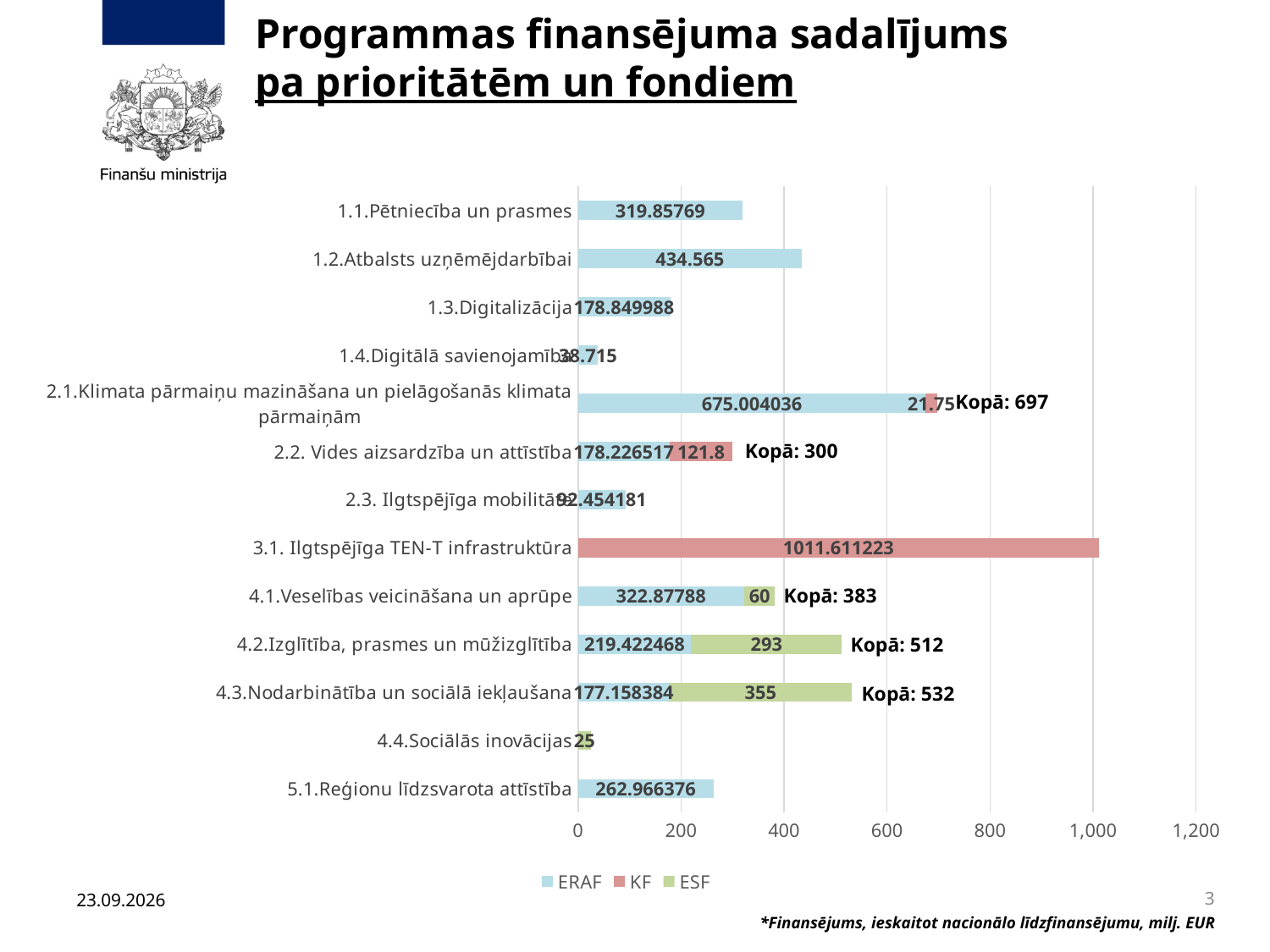
What is the ERAF value for 2.1.Klimata pārmaiņu mazināšana un pielāgošanās klimata pārmaiņām? 675.004036 What is the KF value for 3.1. Ilgtspējīga TEN-T infrastruktūra? 1011.611223 Which has the larger ESF value: 4.2.Izglītība, prasmes un mūžizglītība or 4.3.Nodarbinātība un sociālā iekļaušana? 4.3.Nodarbinātība un sociālā iekļaušana What is the difference between the ESF values for 4.3.Nodarbinātība un sociālā iekļaušana and 4.2.Izglītība, prasmes un mūžizglītība? 62 What is the ESF value for 4.3.Nodarbinātība un sociālā iekļaušana? 355 Which series is shown in green in the legend? ESF Which category has the longest bar on the chart? 3.1. Ilgtspējīga TEN-T infrastruktūra What kind of chart is shown on the slide? bar chart What is the total (Kopā) shown for 4.2.Izglītība, prasmes un mūžizglītība? 512 What is the ERAF value for 1.2.Atbalsts uzņēmējdarbībai? 434.565 How many categories (priorities) are plotted on the chart? 13 How many series does the legend list? 3